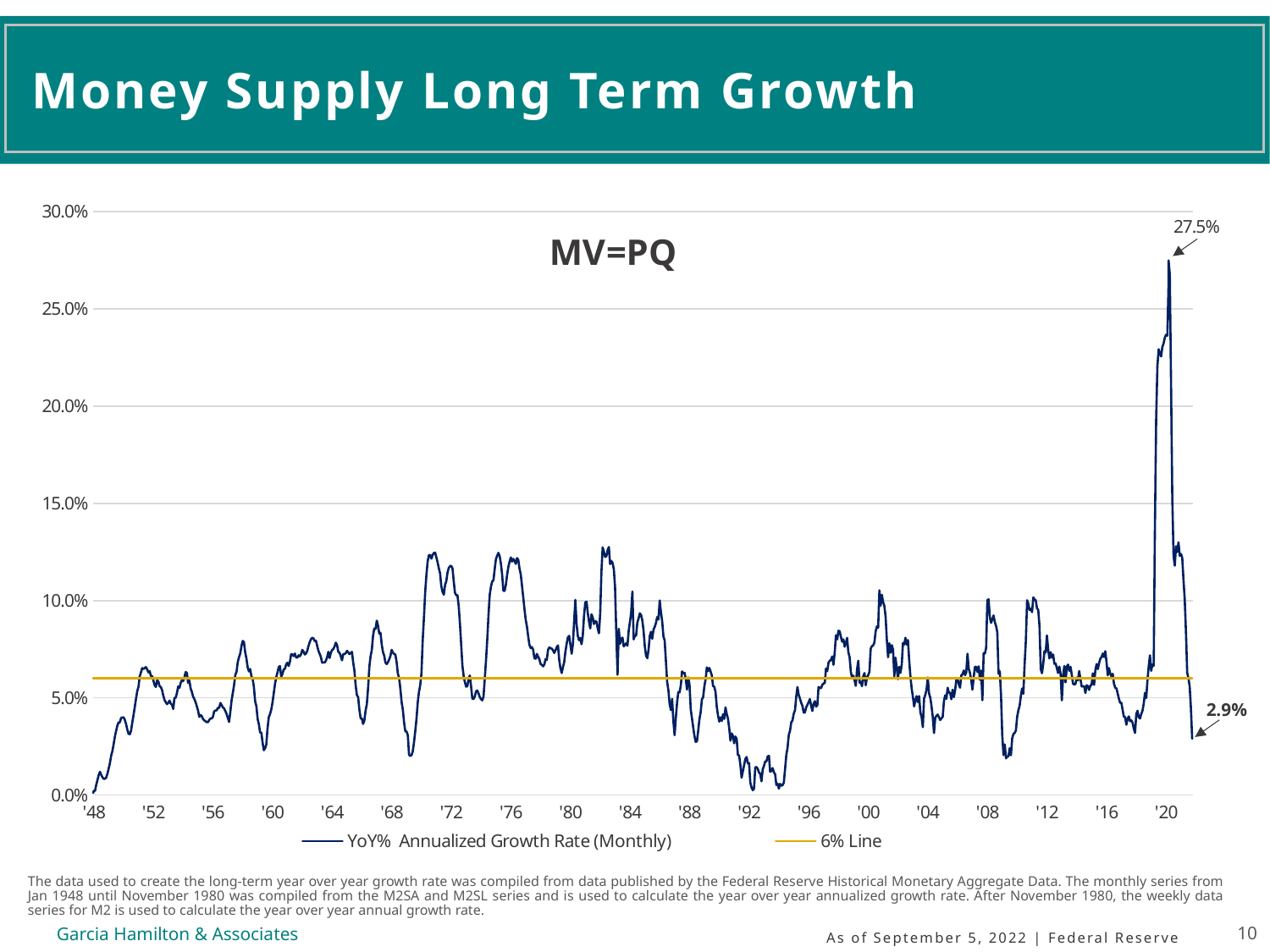
Is the YoY% growth rate around '72 greater or less than 10.0%? greater What kind of chart is shown on the slide? Line chart What is the peak value labeled on the YoY% Annualized Growth Rate line? 27.5% What is the difference between the labeled peak value of 27.5% and the labeled latest value of 2.9%? 24.6 percentage points At what level is the horizontal reference line drawn, according to the legend? 6% Line What is the highest value shown on the y-axis? 30.0% Which labeled value is larger, the peak near '20 or the latest value at the end of the line? The peak near '20 (27.5%) How many series does the legend list? 2 After reaching the 27.5% peak, does the YoY% growth rate line rise or fall toward the end of the chart? Fall Is the YoY% growth rate around '93 greater or less than 5.0%? less What is the title of the slide containing the chart? Money Supply Long Term Growth What is the most recent value labeled at the end of the YoY% Annualized Growth Rate line? 2.9%